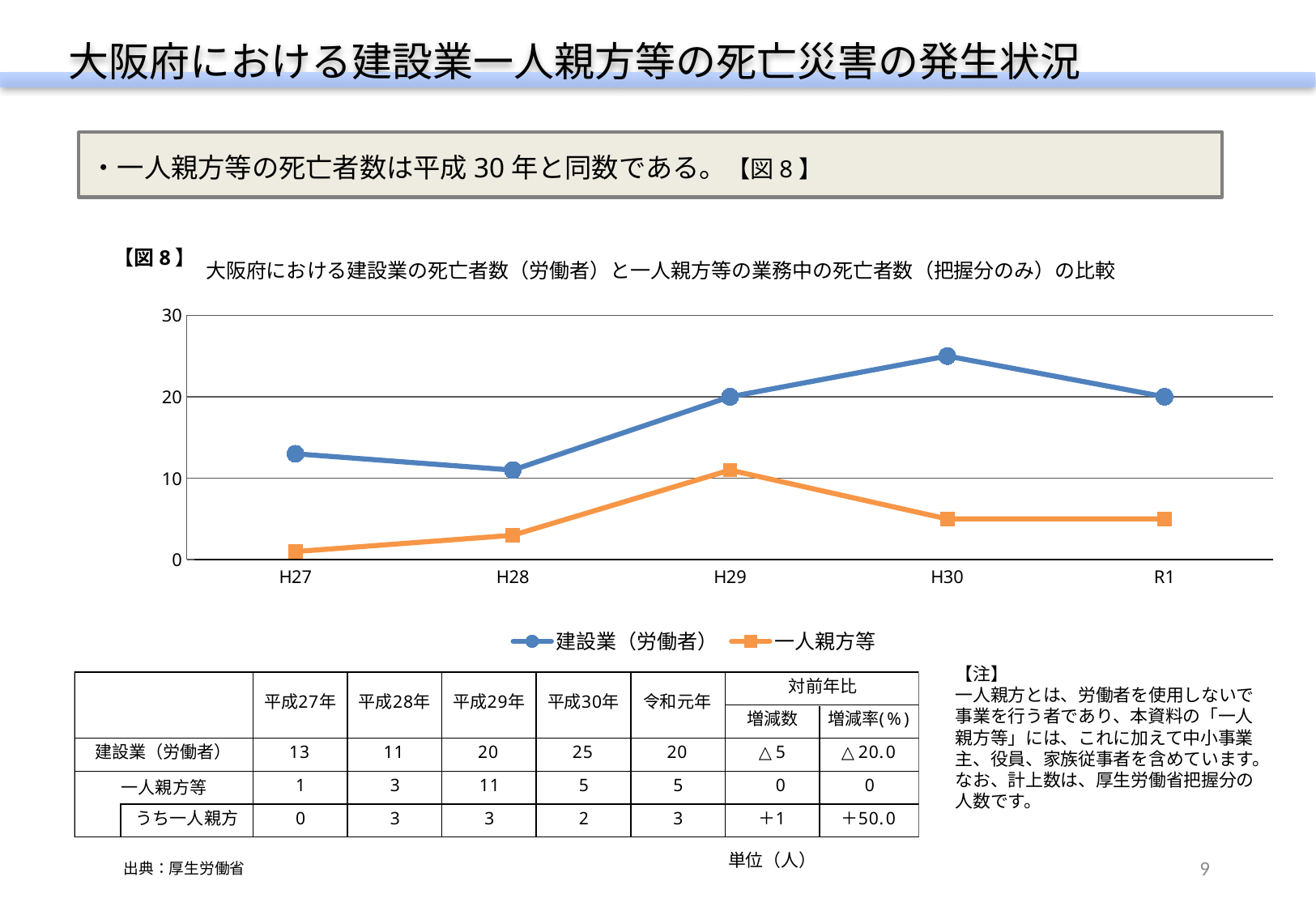
What is the value for 建設業（労働者） in R1? 20 Does the value for 一人親方等 rise or fall from H29 to H30? fall What is the value for 建設業（労働者） in H30? 25 In which year is the value for 一人親方等 lowest? H27 Is the value for 建設業（労働者） in H27 greater or less than 10? greater What is the difference between 建設業（労働者） and 一人親方等 in H29? 9 In which year is the value for 建設業（労働者） highest? H30 How many years are plotted along the x axis of the chart? 5 What kind of chart is shown in 図8? line chart What is the value for 一人親方等 in H29? 11 Which series has the larger value in H28, 建設業（労働者） or 一人親方等? 建設業（労働者） How many series does the legend of the chart list? 2